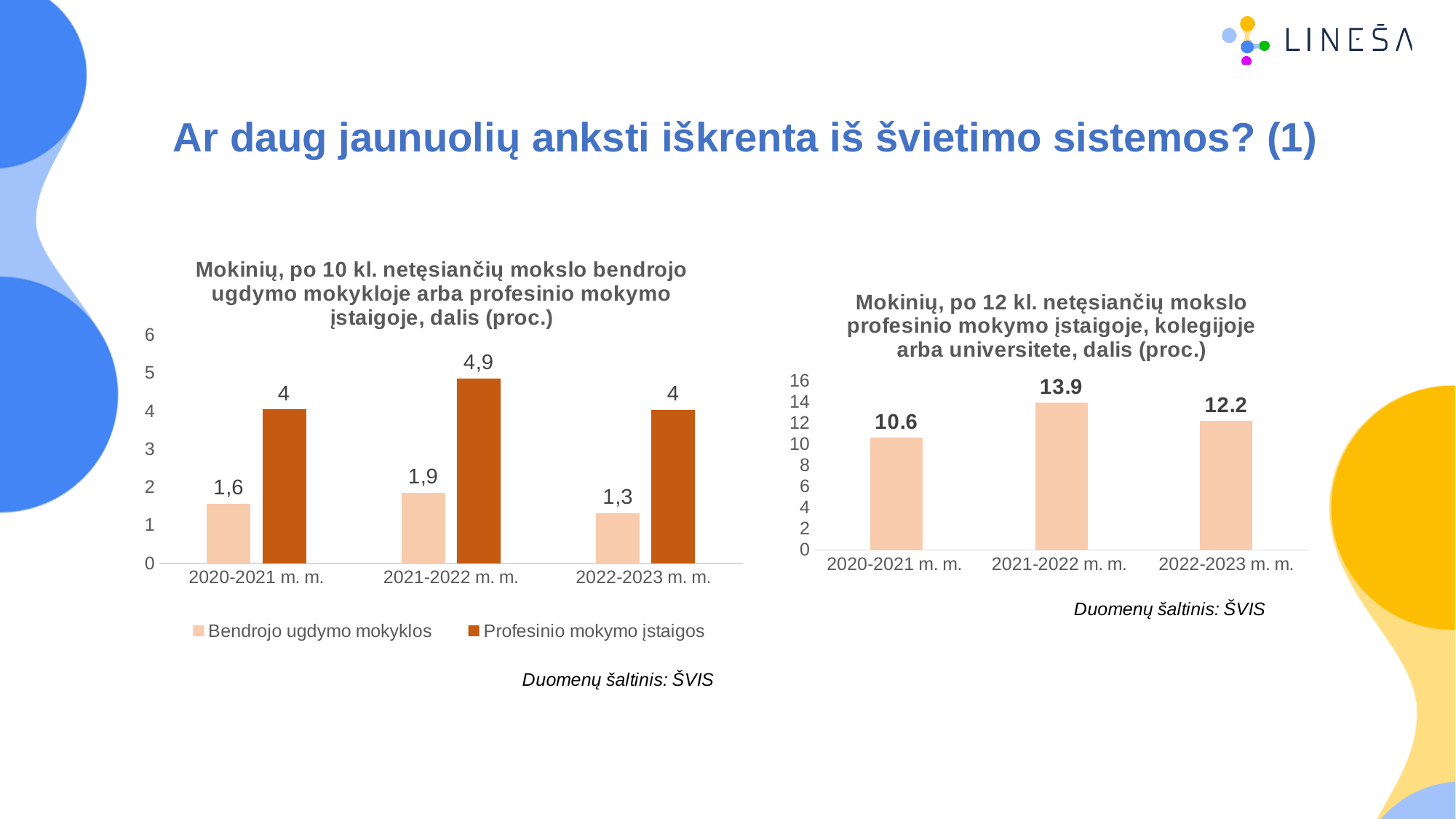
What type of chart is the right chart? Bar chart In the left chart, what is the value for Bendrojo ugdymo mokyklos in 2021-2022 m. m.? 1,9 In the left chart, what is the value for Profesinio mokymo įstaigos in 2021-2022 m. m.? 4,9 In the left chart, what is the difference between Profesinio mokymo įstaigos and Bendrojo ugdymo mokyklos in 2020-2021 m. m.? 2,4 In the right chart, how many school years are shown on the x axis? 3 In the left chart, what is the value for Bendrojo ugdymo mokyklos in 2022-2023 m. m.? 1,3 In the left chart, how many series does the legend list? 2 In the right chart, what is the difference between 2021-2022 m. m. and 2022-2023 m. m.? 1.7 In the left chart, which school year has the lowest value for Bendrojo ugdymo mokyklos? 2022-2023 m. m. In the right chart, which school year has the highest value? 2021-2022 m. m. In the left chart, which series is shown in dark orange? Profesinio mokymo įstaigos In the right chart, what is the value for 2020-2021 m. m.? 10.6